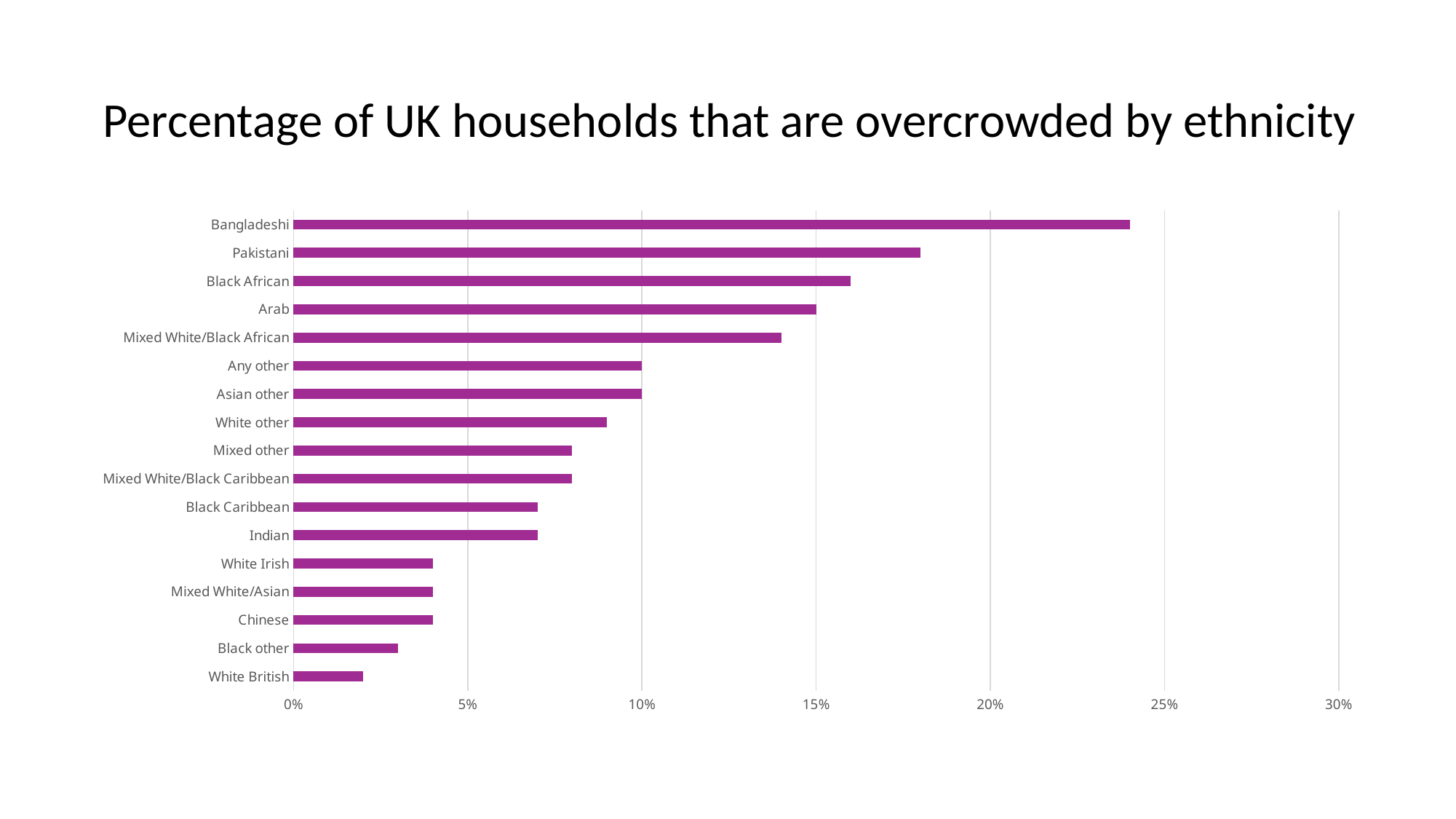
What kind of chart is shown on the slide? bar chart Is the value for White other greater or less than 10%? less Is the value for Mixed White/Black African greater or less than 15%? less Is the value for Chinese greater or less than 5%? less Which has a higher percentage of overcrowded households, Black Caribbean or White Irish? Black Caribbean How many ethnicity categories are plotted on the chart? 17 Which ethnicity has the lowest percentage of overcrowded households? White British What is the title of the chart? Percentage of UK households that are overcrowded by ethnicity Which ethnicity has the highest percentage of overcrowded households? Bangladeshi